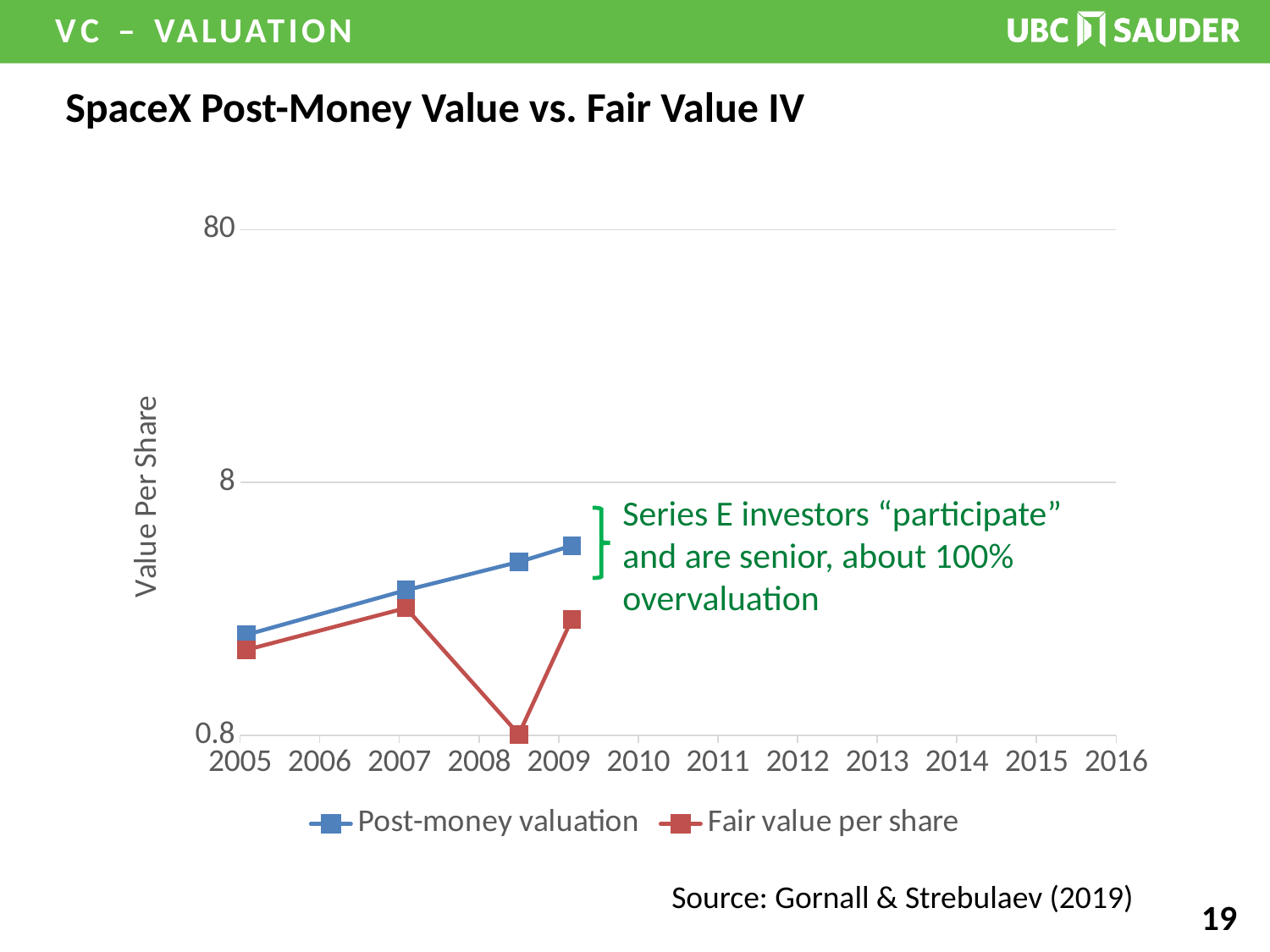
Does the Post-money valuation series rise or fall from 2005 to 2009? rise How many data points are plotted for the Post-money valuation series? 4 Which series contains the lowest plotted point on the chart? Fair value per share In 2009, which is larger: the Post-money valuation or the Fair value per share? Post-money valuation In which year does the Post-money valuation series reach its highest value? 2009 Is the Fair value per share at its lowest point (between 2008 and 2009) greater or less than 8? less Is the Post-money valuation in 2009 greater or less than 8? less What are the two series named in the legend? Post-money valuation and Fair value per share Is the Post-money valuation in 2005 greater or less than 8? less What kind of chart is shown on the slide? line chart How many series does the legend list? 2 What is the label on the vertical axis? Value Per Share